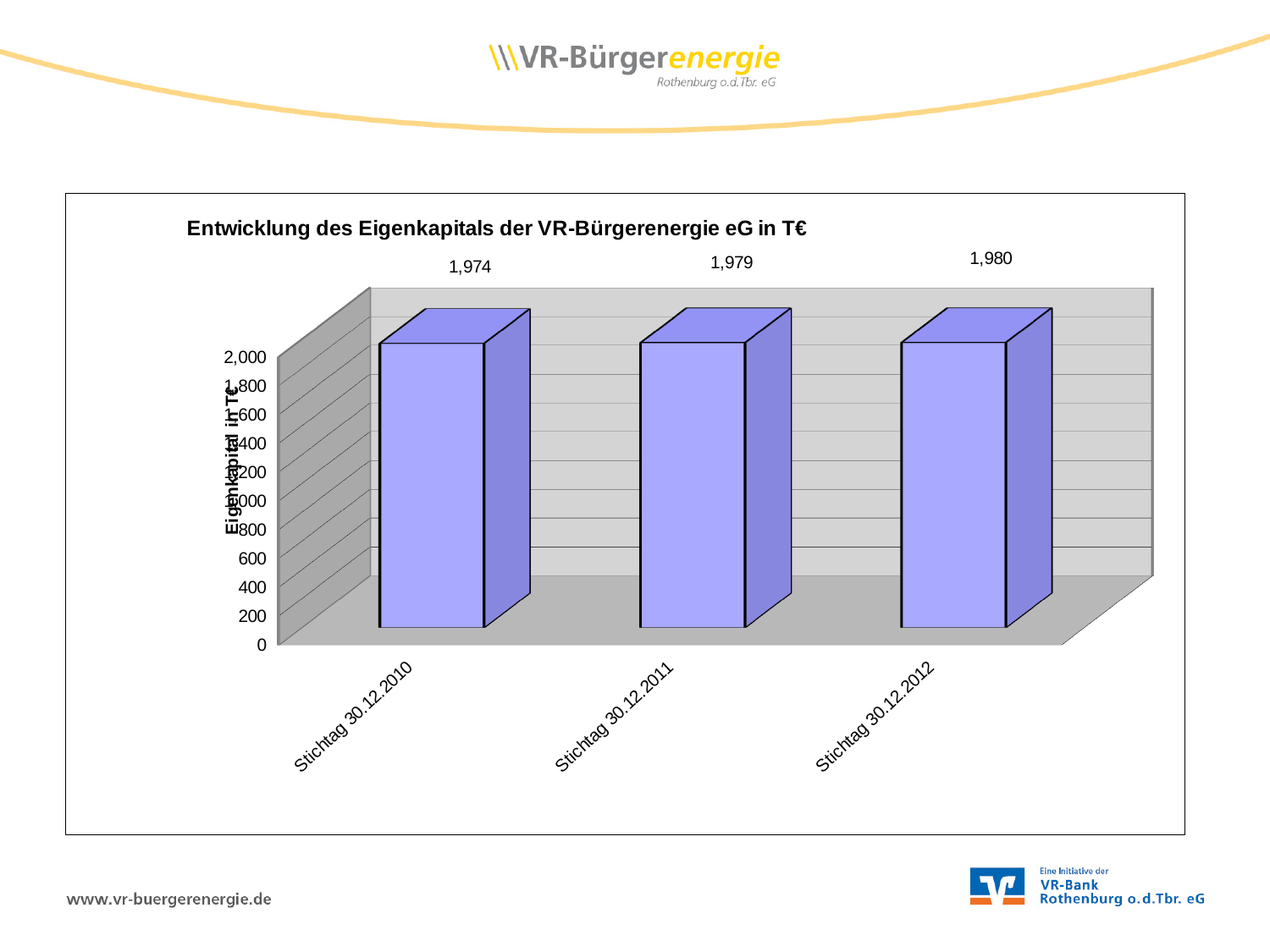
What kind of chart is shown on the slide? bar chart Do the values rise or fall from Stichtag 30.12.2010 to Stichtag 30.12.2012? rise What is the title of the chart? Entwicklung des Eigenkapitals der VR-Bürgerenergie eG in T€ Which is larger, the value for Stichtag 30.12.2011 or for Stichtag 30.12.2010? Stichtag 30.12.2011 What is the difference between the values for Stichtag 30.12.2012 and Stichtag 30.12.2010? 6 How many Stichtag categories are shown on the x axis? 3 Which Stichtag has the highest Eigenkapital value? Stichtag 30.12.2012 What is the value for Stichtag 30.12.2011? 1,979 What is the value for Stichtag 30.12.2010? 1,974 Which Stichtag has the lowest Eigenkapital value? Stichtag 30.12.2010 What is the value for Stichtag 30.12.2012? 1,980 Is the value for Stichtag 30.12.2011 greater or less than 1,000? greater